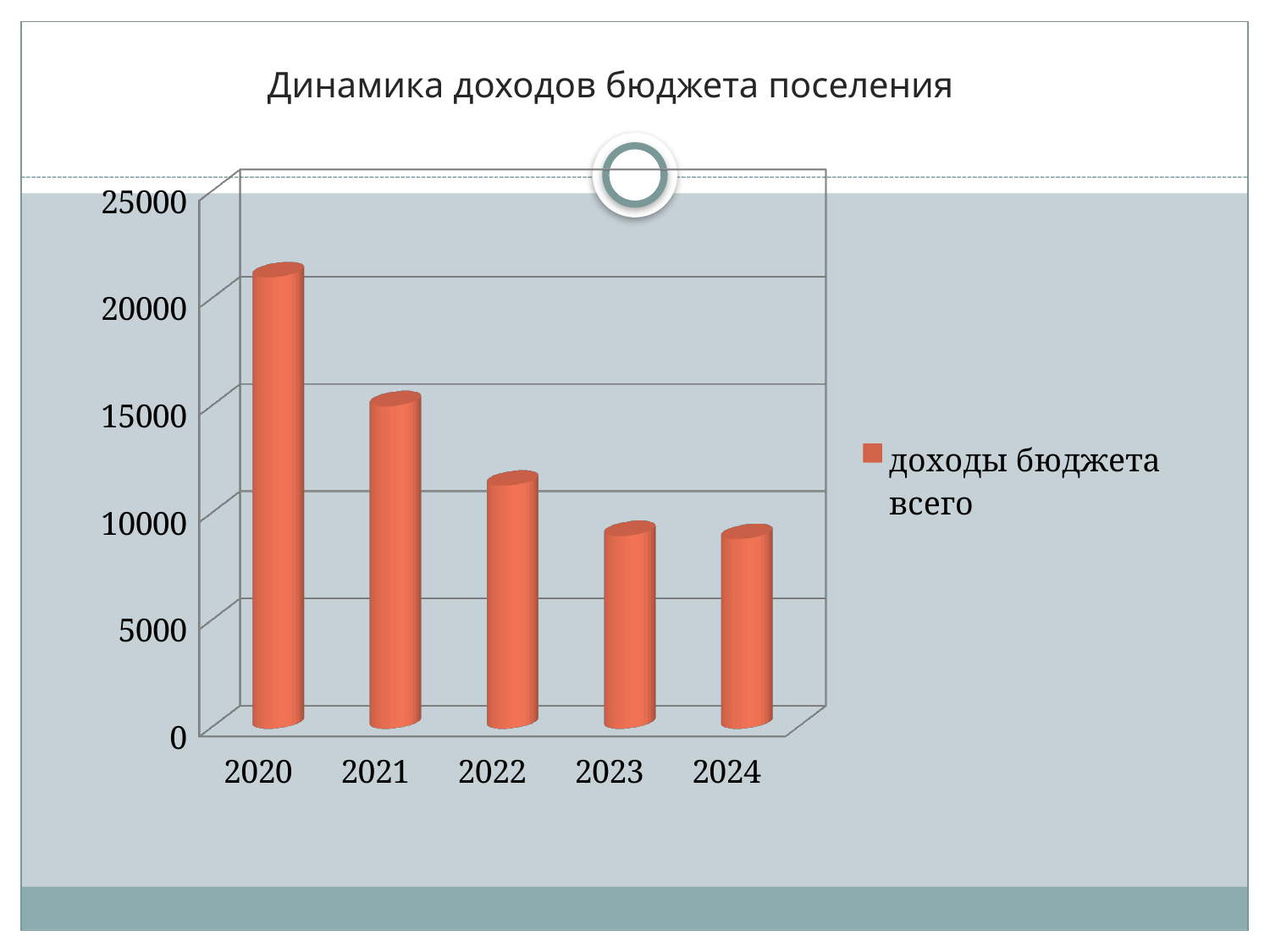
Is the value for 2022 greater or less than 15000? less How many series does the legend list? 1 Is the value for 2020 greater or less than 20000? greater Which is larger, the value for 2021 or the value for 2022? 2021 Is the value for 2023 greater or less than 10000? less Do the values rise or fall from 2020 to 2024? fall What kind of chart is shown on the slide? bar chart What is the name of the series shown in the legend? доходы бюджета всего What is the title of the chart? Динамика доходов бюджета поселения Which year has the highest value for доходы бюджета всего? 2020 How many years are shown on the x axis? 5